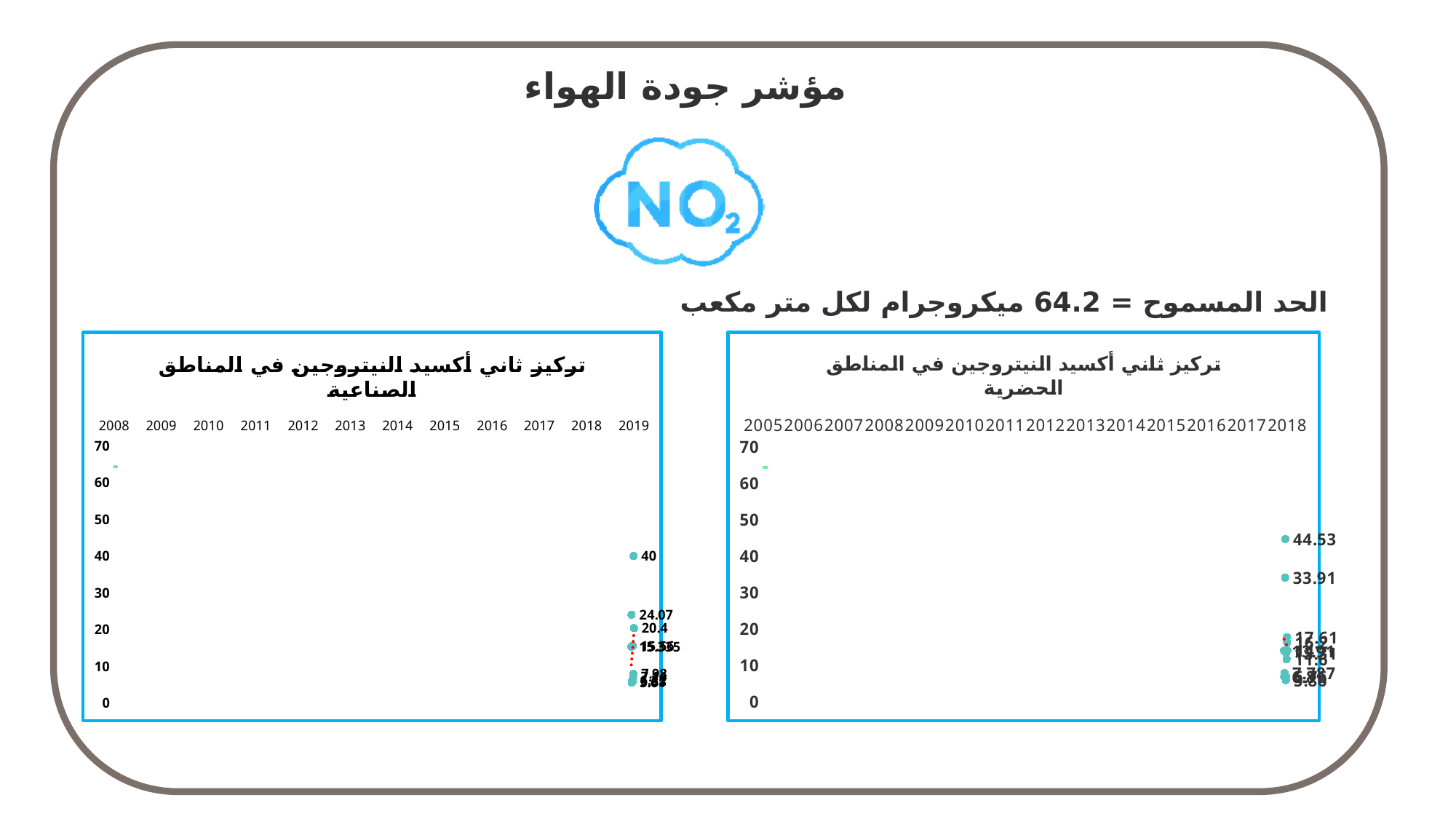
On the left chart (industrial areas), what is the second-highest labelled value? 24.07 Is the highest labelled value on the left chart (industrial areas) greater or less than 50? less On the right chart (urban areas), what is the second-highest labelled value? 33.91 Is the highest labelled value on the right chart (urban areas) greater or less than 40? greater What is the difference between the highest labelled value on the right chart (44.53) and the highest labelled value on the left chart (40)? 4.53 How many years are listed along the x axis of the left chart (industrial areas)? 12 What is the maximum value shown on the y axis of the left chart (industrial areas)? 70 Which chart has the larger maximum labelled value, the left chart (industrial areas) or the right chart (urban areas)? the right chart (urban areas) What is the highest data label shown on the right chart (urban areas)? 44.53 What is the first year shown on the x axis of the right chart (urban areas)? 2005 How many years are listed along the x axis of the right chart (urban areas)? 14 What is the highest data label shown on the left chart (industrial areas)? 40